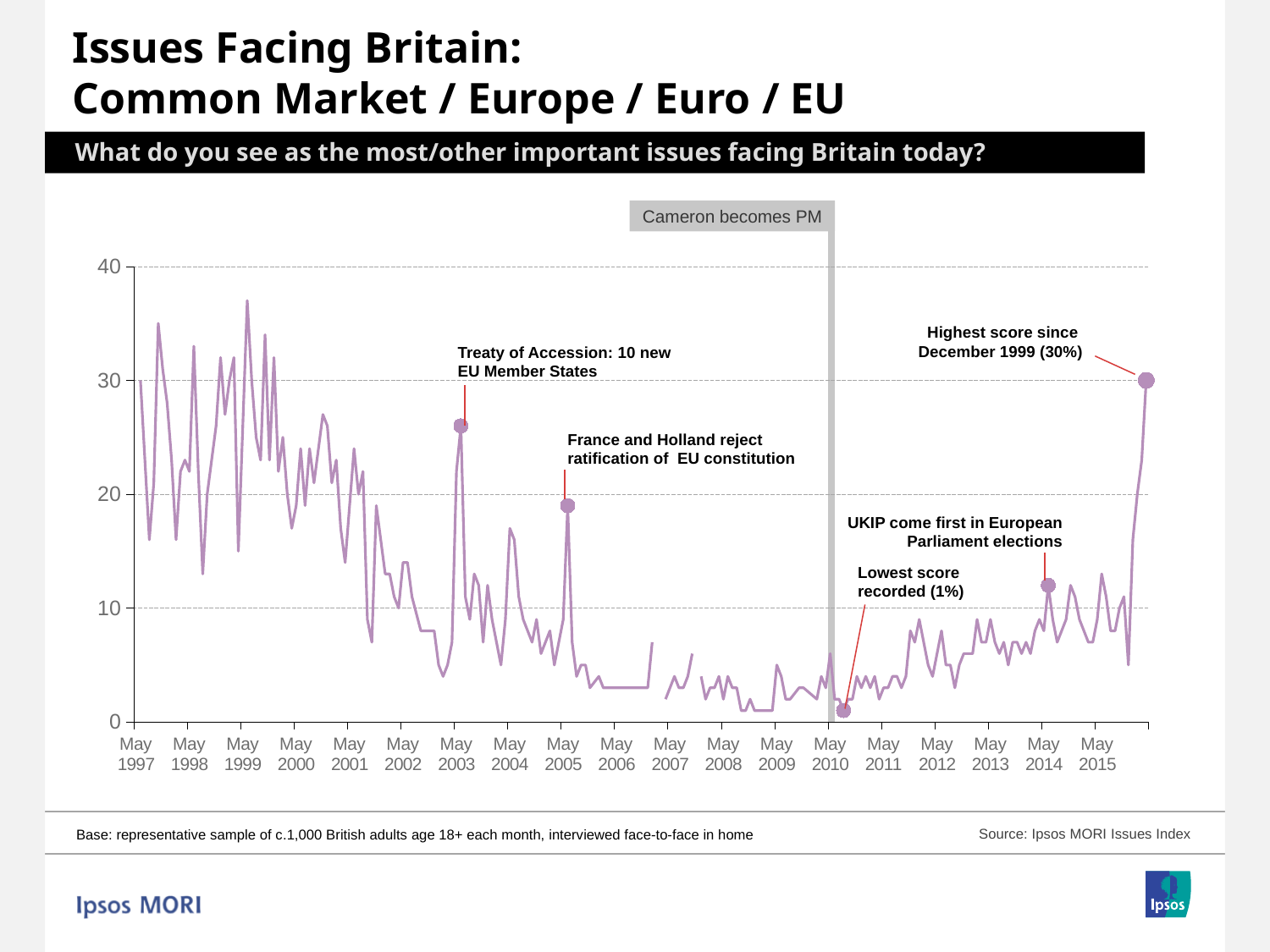
What value is given for the point labelled 'Highest score since December 1999'? 30% What event does the vertical grey bar on the chart mark? Cameron becomes PM Is the value at the point marked 'Treaty of Accession: 10 new EU Member States' greater or less than 20? greater What survey question is shown in the black banner above the chart? What do you see as the most/other important issues facing Britain today? Does the line generally rise or fall between May 1997 and May 2010? fall Is the value at the point marked 'UKIP come first in European Parliament elections' greater or less than 10? greater Which marked point is higher: 'Treaty of Accession: 10 new EU Member States' or 'France and Holland reject ratification of EU constitution'? Treaty of Accession: 10 new EU Member States What is the difference between the highest score since December 1999 (30%) and the lowest score recorded (1%)? 29 percentage points What value is given for the point labelled 'Lowest score recorded'? 1% How many points on the line are marked with a dot and an annotation? 5 What kind of chart is shown on the slide? line chart Is the value at the point marked 'France and Holland reject ratification of EU constitution' greater or less than 10? greater